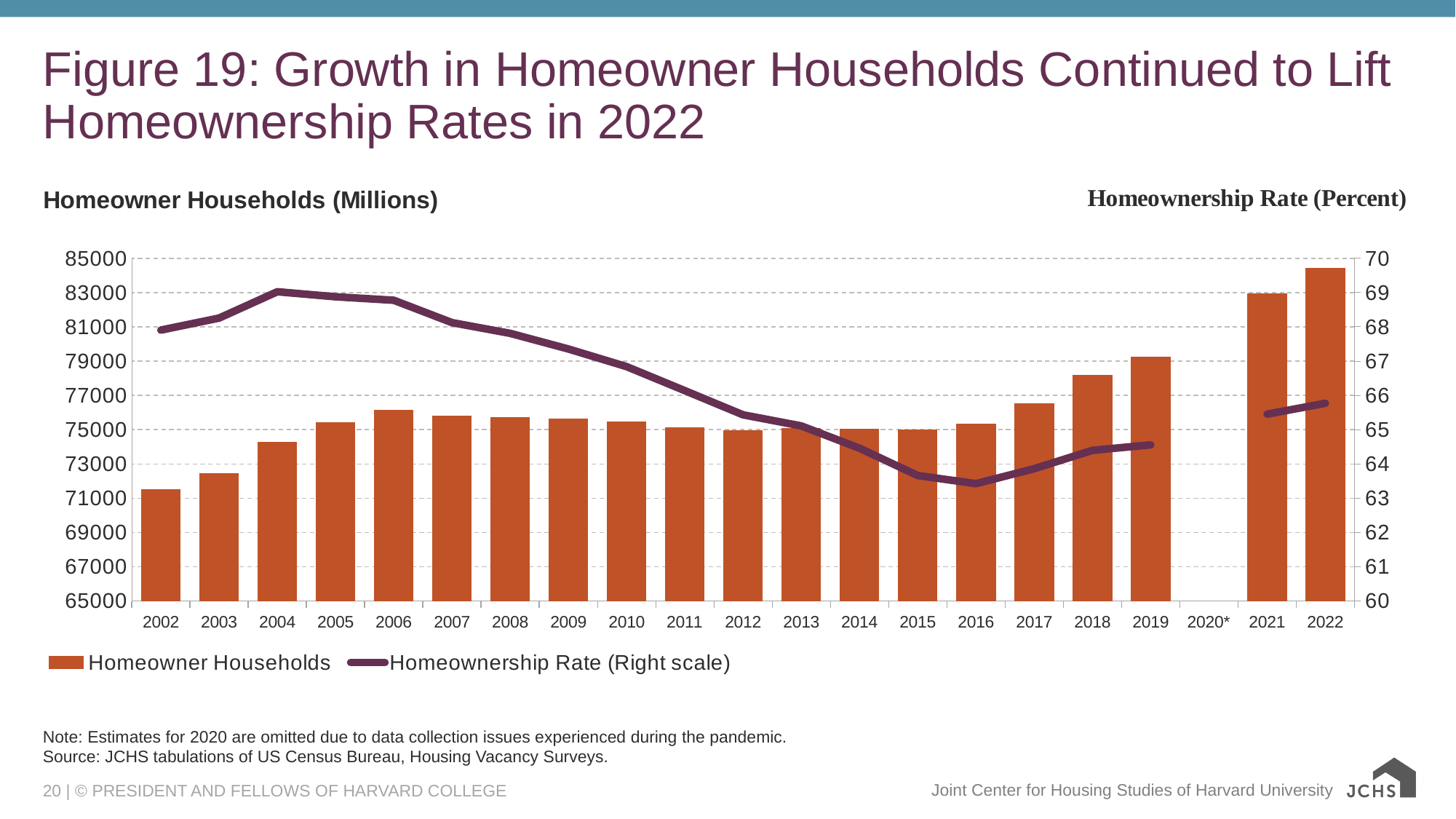
Is the Homeowner Households value for 2022 greater or less than 83000? greater In which year does the Homeownership Rate line reach its highest point? 2004 Does the Homeownership Rate line rise or fall between 2004 and 2016? It falls In which year does the Homeownership Rate line reach its lowest point? 2016 Is the Homeownership Rate for 2016 greater or less than 64? less Which year is marked with an asterisk on the x axis and has no data shown? 2020* How many series does the legend list? 2 What kind of chart is shown on the slide? A bar chart combined with a line Which year has the shortest Homeowner Households bar? 2002 Is the Homeownership Rate for 2004 greater or less than 68? greater Which year has the tallest Homeowner Households bar? 2022 Which year has more Homeowner Households, 2019 or 2021? 2021